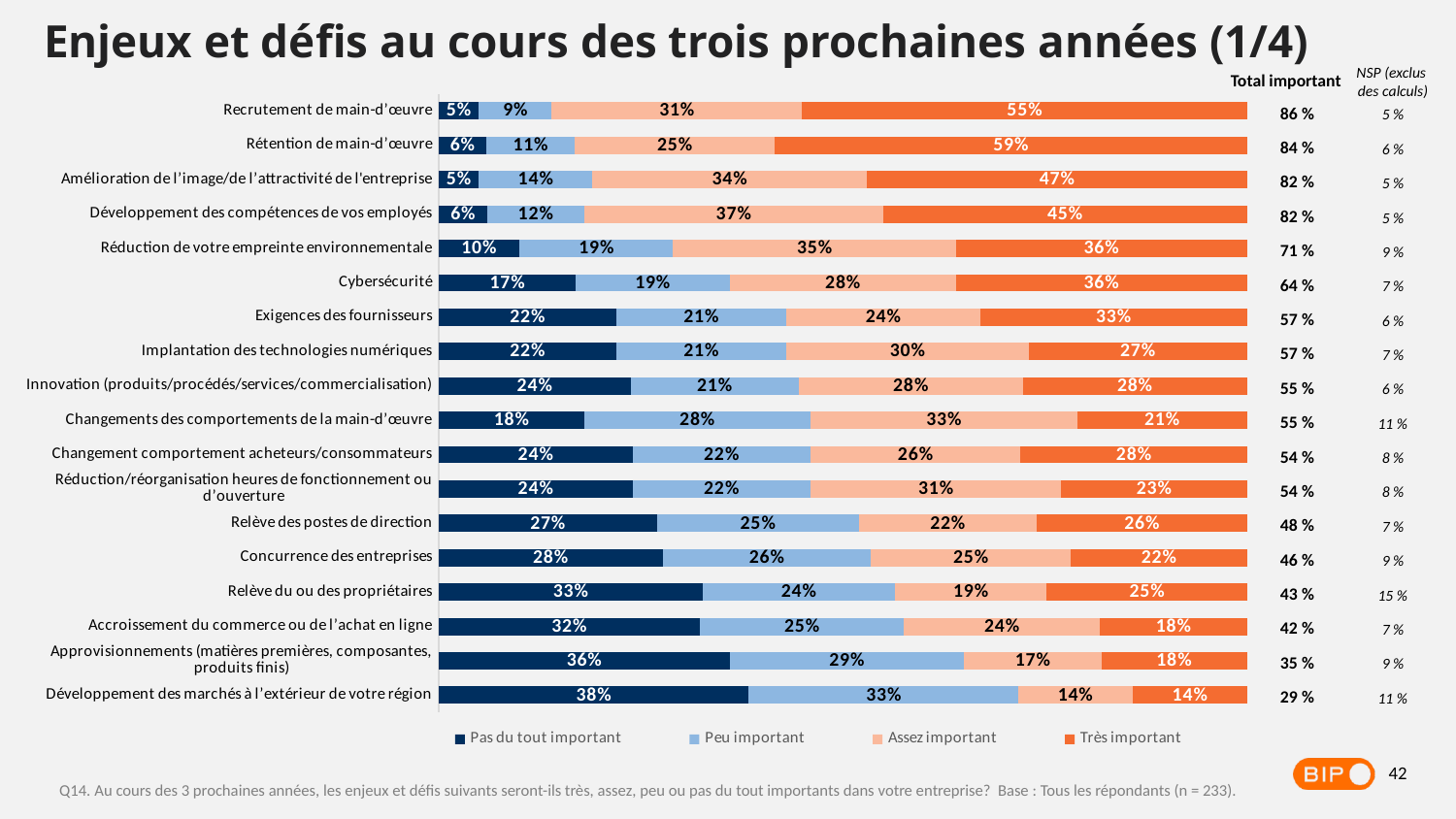
Which has the larger 'Peu important' value: 'Cybersécurité' or 'Exigences des fournisseurs'? Exigences des fournisseurs Which category has the highest 'Très important' value? Rétention de main-d'œuvre Which category has the highest 'Pas du tout important' value? Développement des marchés à l'extérieur de votre région What is the 'Pas du tout important' value for 'Cybersécurité'? 17% What is the 'Assez important' value for 'Développement des compétences de vos employés'? 37% What is the combined 'Pas du tout important' and 'Peu important' value for 'Relève du ou des propriétaires'? 57% How many series does the legend list? 4 What is the 'Très important' value for 'Rétention de main-d'œuvre'? 59% What is the difference between the 'Très important' and 'Assez important' values for 'Recrutement de main-d'œuvre'? 24 percentage points How many categories (enjeux et défis) are plotted in the chart? 18 Which category has the lowest 'Très important' value? Développement des marchés à l'extérieur de votre région What kind of chart is shown on the slide? Stacked bar chart